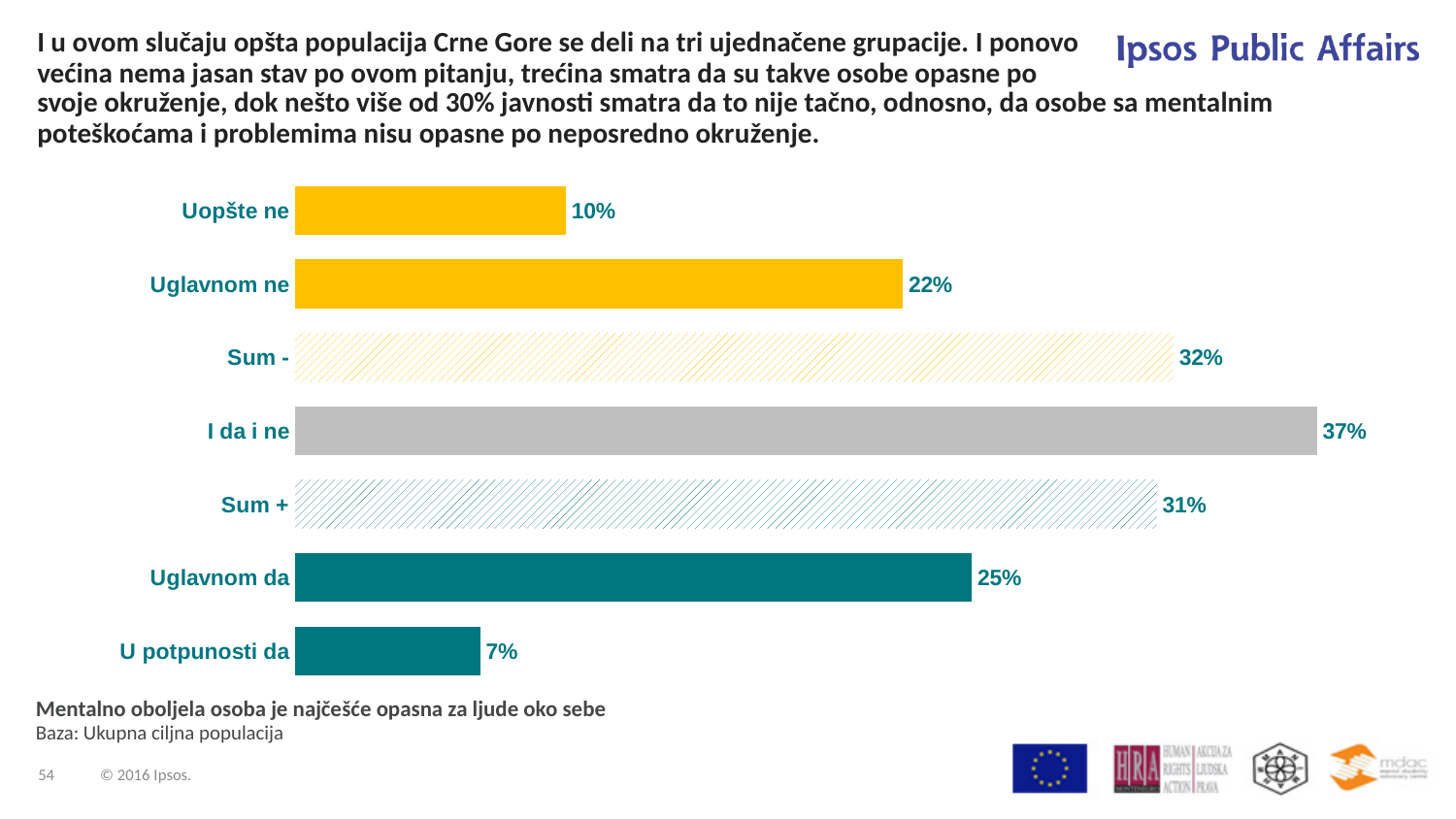
What is the statement shown below the chart that the respondents were asked about? Mentalno oboljela osoba je najčešće opasna za ljude oko sebe What is the value for "Uopšte ne"? 10% What is the value for "Uglavnom ne"? 22% Which category has the lowest value? U potpunosti da What is the value for "U potpunosti da"? 7% Which is larger, "Sum -" or "Sum +"? Sum - What is the value for "I da i ne"? 37% How many categories are shown in the chart? 7 What kind of chart is shown on the slide? Bar chart Which category has the highest value? I da i ne What is the difference between "Uglavnom da" and "Uglavnom ne"? 3% What is the value for "Sum +"? 31%